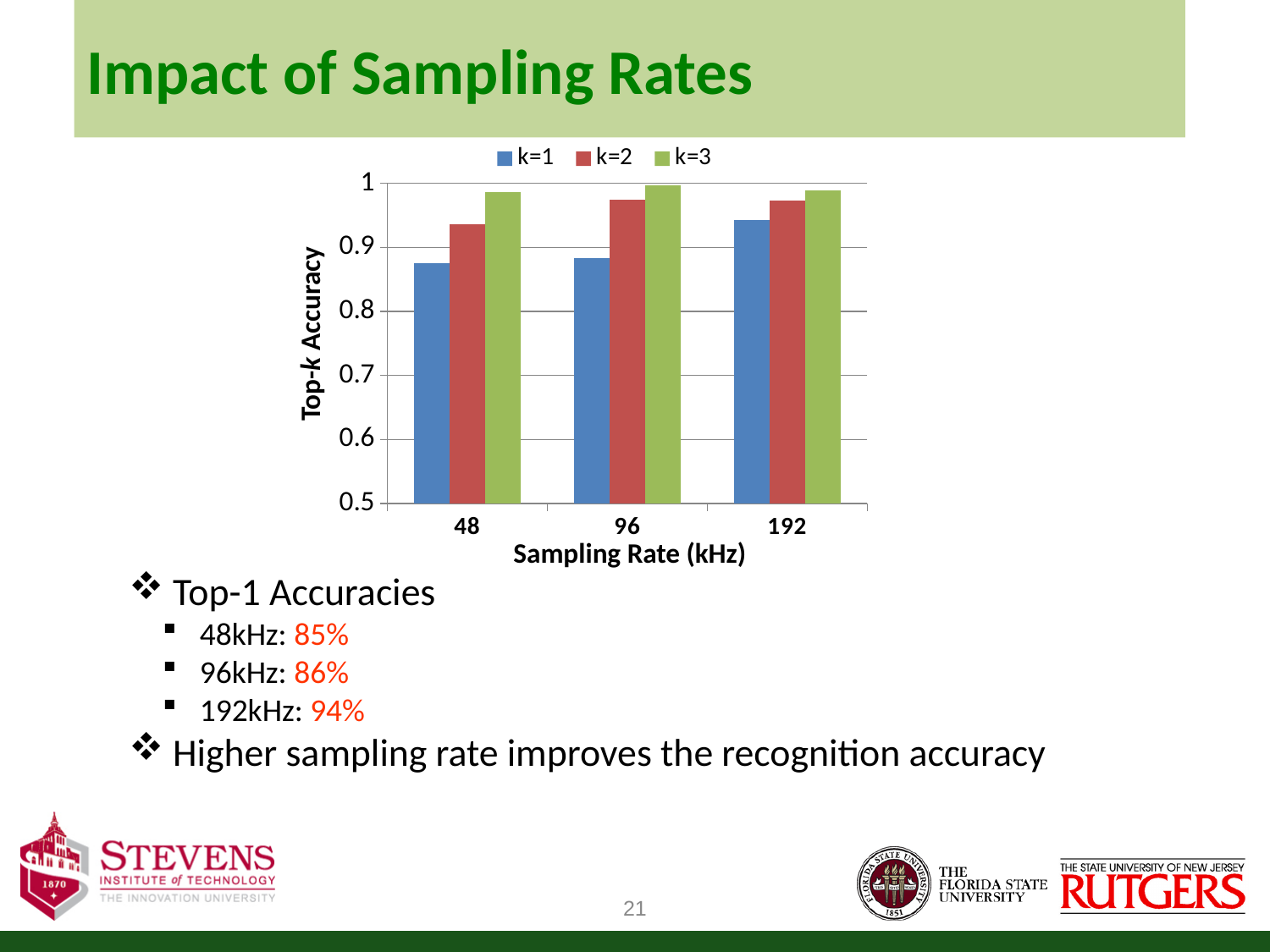
Is the k=1 value at 96 kHz greater or less than 0.9? less How many sampling rate categories are shown on the x axis? 3 Is the k=3 value at 48 kHz greater or less than 0.9? greater What is the title of the x axis? Sampling Rate (kHz) What kind of chart is shown on the slide? bar chart At 48 kHz, which is larger: the k=1 value or the k=3 value? k=3 What is the title of the y axis? Top-k Accuracy Do the k=1 values rise or fall as the sampling rate increases along the x axis? rise How many series does the chart legend list? 3 For the k=1 series, which sampling rate has the highest accuracy? 192 Is the k=1 value at 192 kHz greater or less than 0.9? greater